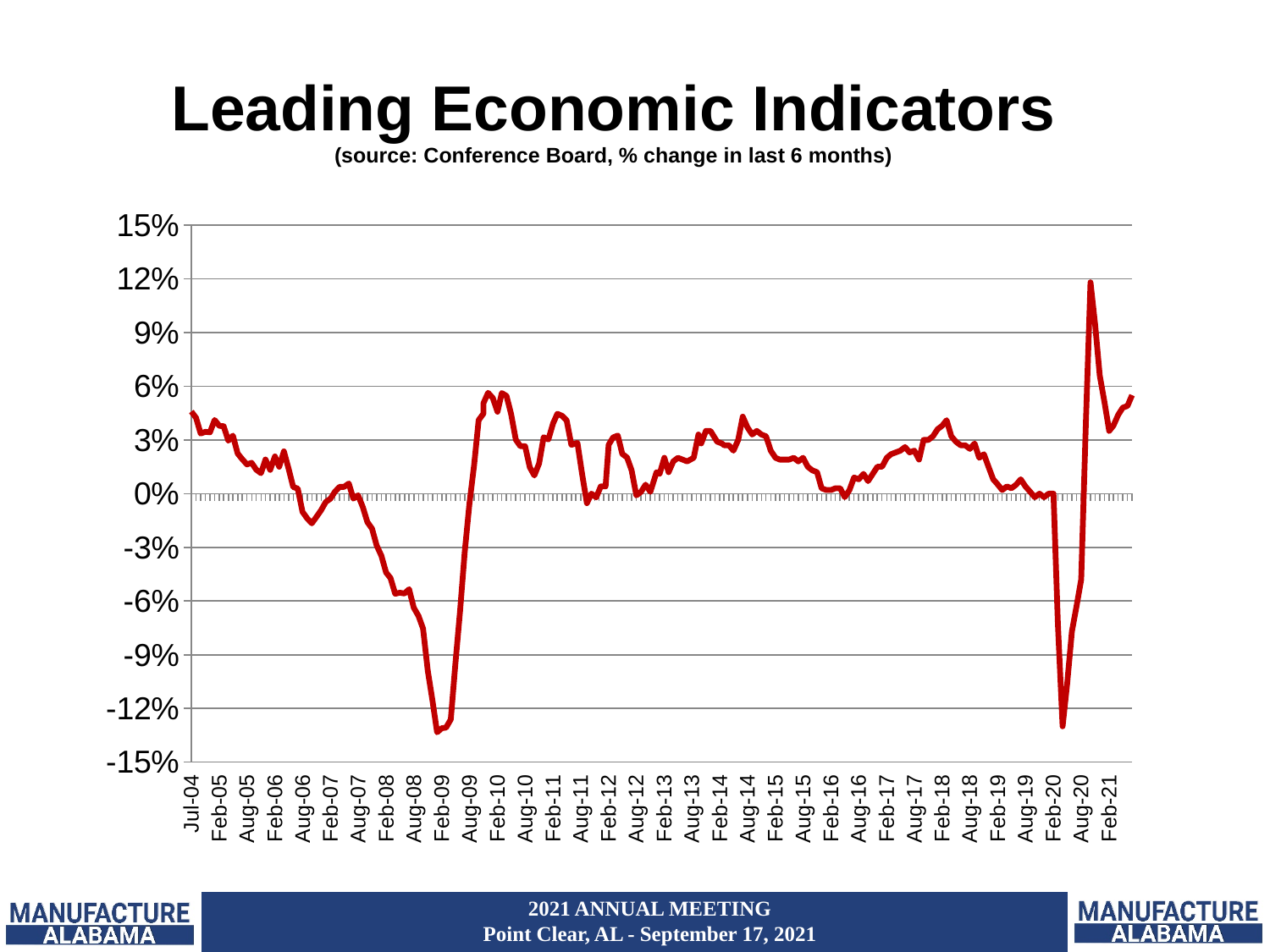
Which is larger, the value at Aug-20 or the value at Feb-10? Feb-10 Is the value at Feb-10 greater or less than 3%? greater What colour is the plotted line? red Around which x-axis label does the line reach its highest value? Aug-20 Does the line rise or fall between Feb-08 and Feb-09? fall What kind of chart is shown on the slide? line chart What is the title of the chart? Leading Economic Indicators Is the value at Aug-08 greater or less than -3%? less Is the value at Feb-09 greater or less than -12%? less